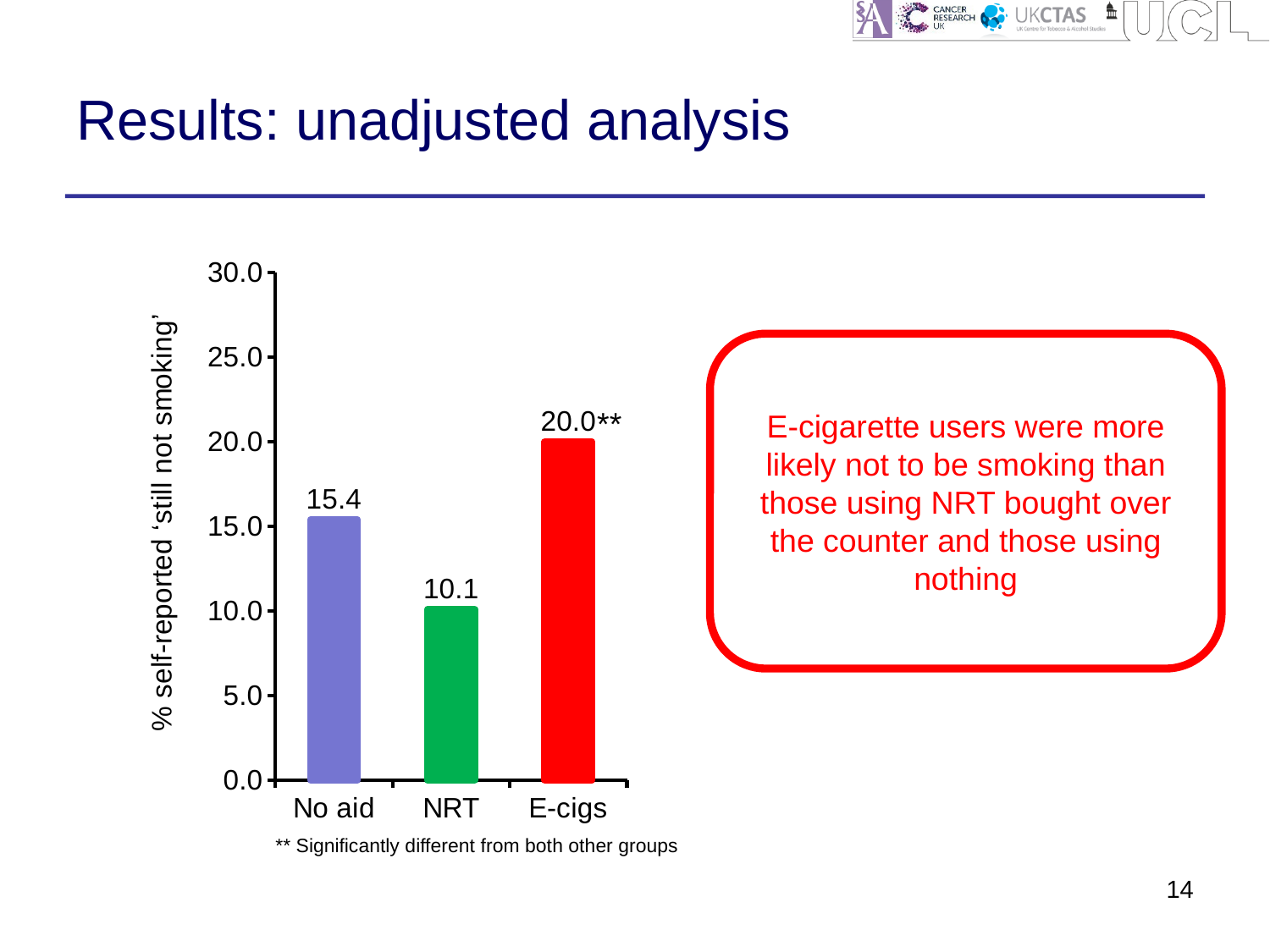
Which category has the highest value? E-cigs What kind of chart is shown on the slide? bar chart What is the difference between the values for E-cigs and NRT? 9.9 What is the value for NRT? 10.1 How many categories are shown on the x axis? 3 Which is larger, the value for No aid or the value for NRT? No aid What is the value for No aid? 15.4 Is the value for No aid greater or less than 15.0? greater What is the difference between the values for No aid and NRT? 5.3 Which category has the lowest value? NRT What is the label of the y axis? % self-reported 'still not smoking' What is the value for E-cigs? 20.0